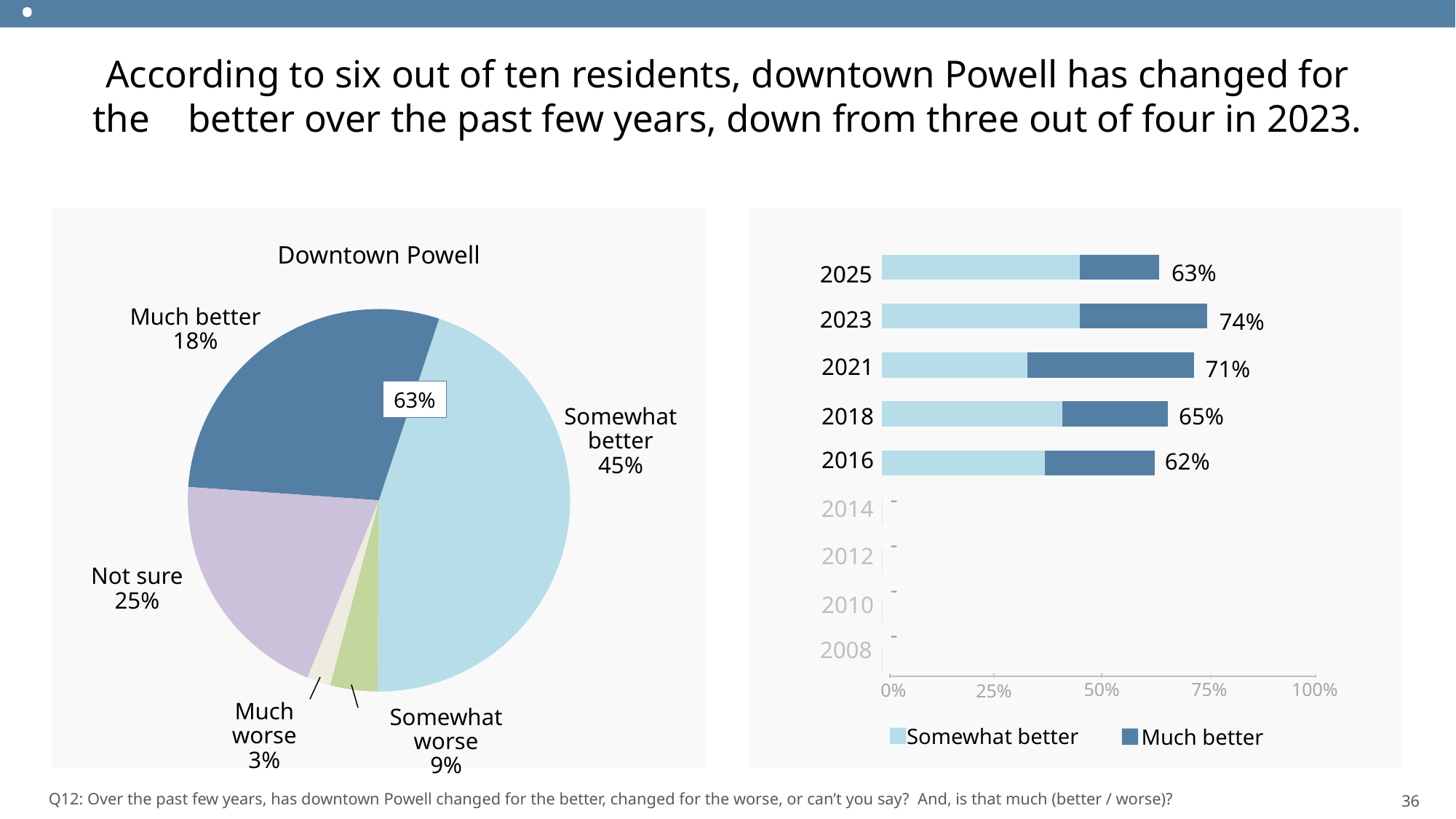
How many slices does the Downtown Powell pie chart have? 5 In the Downtown Powell pie chart, what share of residents said downtown has changed for the somewhat better? 45% In the Downtown Powell pie chart, which response has the largest slice? Somewhat better How many series does the legend of the bar chart on the right list? 2 In the bar chart on the right, by how many percentage points did the total fall from 2023 to 2025? 11% What kind of chart is the chart on the right side of the slide? Stacked bar chart In the Downtown Powell pie chart, what percentage of residents answered Not sure? 25% In the bar chart on the right, which year has the lowest total percentage? 2016 In the Downtown Powell pie chart, what is the difference between the Much better and Much worse percentages? 15% In the Downtown Powell pie chart, which response has the smallest slice? Much worse In the Downtown Powell pie chart, which is larger: Somewhat worse or Much better? Much better In the bar chart on the right, what is the total percentage shown for 2023? 74%